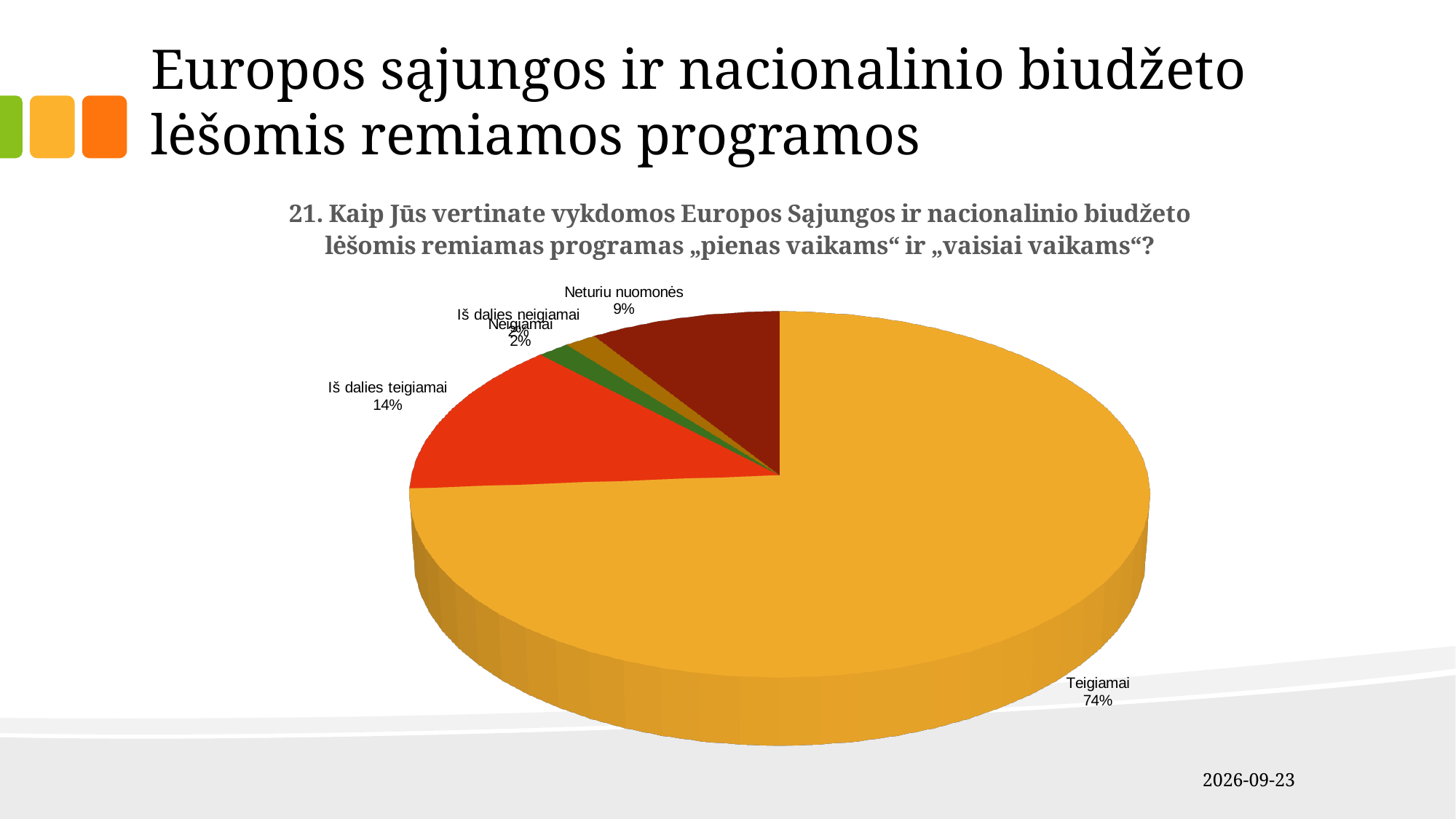
What colour is the "Teigiamai" slice? orange/yellow Which answer category has the largest slice of the pie? Teigiamai What share of respondents answered "Iš dalies teigiamai"? 14% What share of respondents answered "Teigiamai"? 74% How many slices does the pie chart have? 5 What kind of chart is shown on the slide? pie chart What is the difference in percentage points between "Iš dalies teigiamai" and "Neturiu nuomonės"? 5 How many percentage points larger is the "Teigiamai" share than the "Iš dalies teigiamai" share? 60 Which is larger, the share for "Iš dalies teigiamai" or for "Neturiu nuomonės"? Iš dalies teigiamai What question number is shown in the chart title? 21 What share of respondents answered "Neigiamai"? 2% What share of respondents answered "Neturiu nuomonės"? 9%